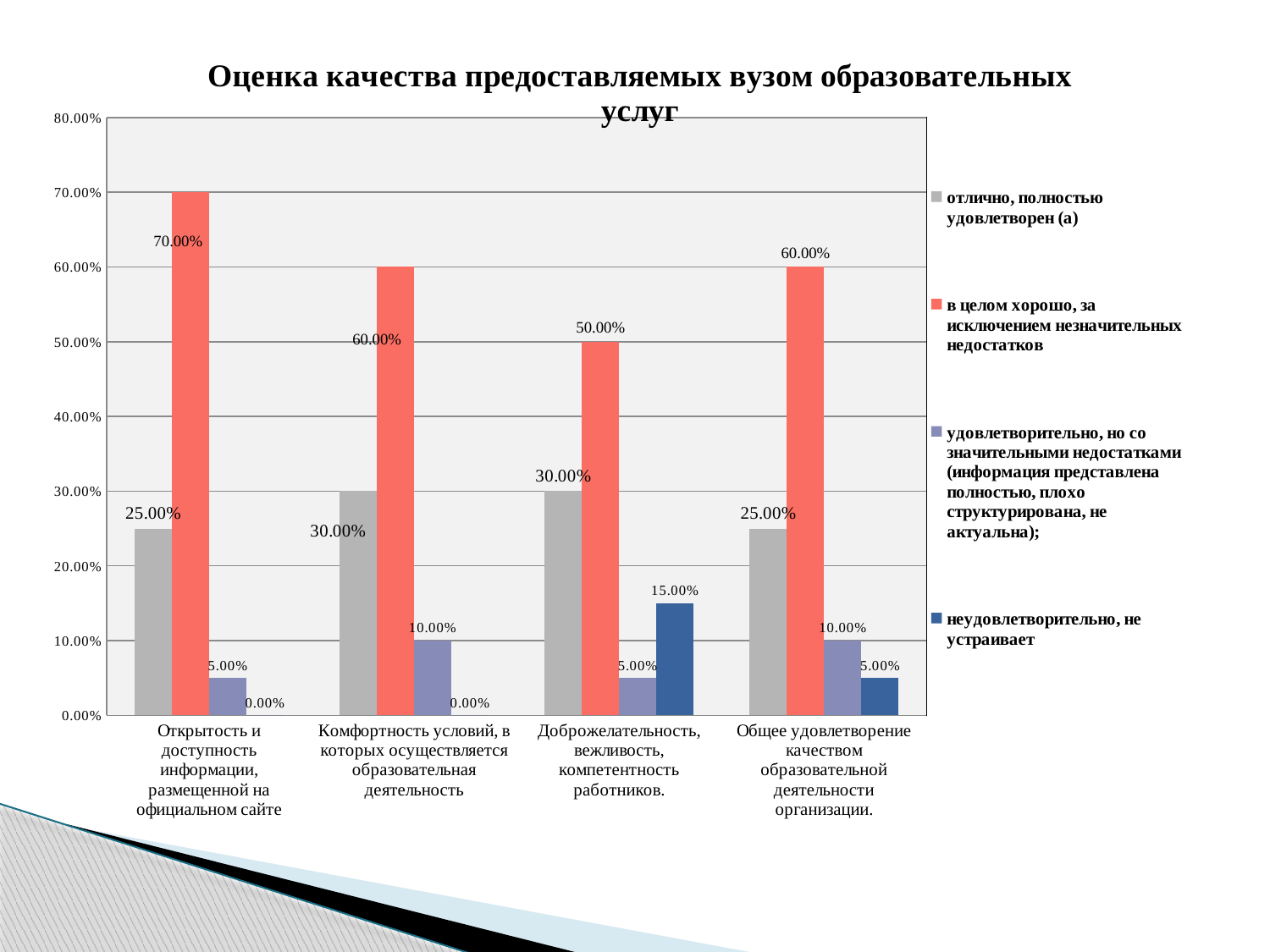
For which category is the value of the series "в целом хорошо, за исключением незначительных недостатков" the highest? Открытость и доступность информации, размещенной на официальном сайте How many categories are shown on the x axis? 4 What type of chart is shown on the slide? Bar chart What is the value of the series "отлично, полностью удовлетворен (а)" for the category "Комфортность условий, в которых осуществляется образовательная деятельность"? 30.00% For which category is the value of the series "в целом хорошо, за исключением незначительных недостатков" the lowest? Доброжелательность, вежливость, компетентность работников What is the value of the series "в целом хорошо, за исключением незначительных недостатков" for the category "Открытость и доступность информации, размещенной на официальном сайте"? 70.00% What is the difference between the "в целом хорошо" value and the "отлично, полностью удовлетворен (а)" value for the category "Общее удовлетворение качеством образовательной деятельности организации"? 35.00% What is the title of the chart? Оценка качества предоставляемых вузом образовательных услуг Is the value of the series "в целом хорошо, за исключением незначительных недостатков" for "Комфортность условий, в которых осуществляется образовательная деятельность" greater or less than 50.00%? greater How many series does the legend list? 4 Which is larger for the category "Доброжелательность, вежливость, компетентность работников": the "неудовлетворительно, не устраивает" value or the "удовлетворительно, но со значительными недостатками" value? неудовлетворительно, не устраивает What is the value of the series "неудовлетворительно, не устраивает" for the category "Доброжелательность, вежливость, компетентность работников"? 15.00%